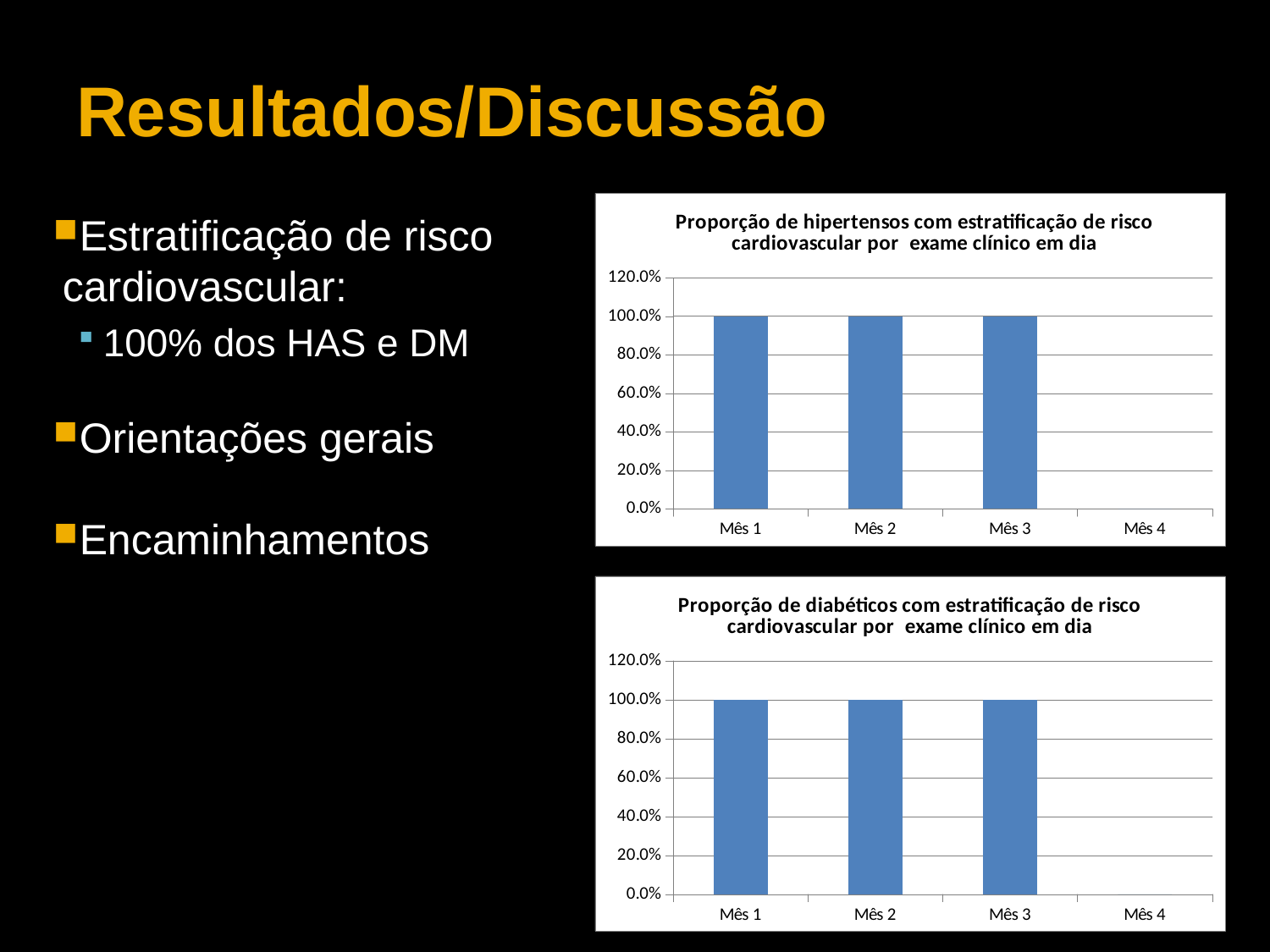
In the top chart (Proporção de hipertensos), what is the difference between the values for Mês 1 and Mês 2? 0.0% In the bottom chart (Proporção de diabéticos), is the value for Mês 1 greater or less than 80.0%? greater In the top chart (Proporção de hipertensos), do the values change from Mês 1 to Mês 3? No, they stay constant In the bottom chart (Proporção de diabéticos), which category has no bar plotted? Mês 4 In the top chart (Proporção de hipertensos), what is the value for Mês 3? 100.0% What is the title of the bottom chart? Proporção de diabéticos com estratificação de risco cardiovascular por exame clínico em dia In the bottom chart (Proporção de diabéticos), what is the value for Mês 3? 100.0% In the bottom chart (Proporção de diabéticos), how many categories are shown on the x axis? 4 What kind of chart is the top chart (Proporção de hipertensos)? Bar chart In the bottom chart (Proporção de diabéticos), what is the value for Mês 2? 100.0% In the top chart (Proporção de hipertensos), what is the value for Mês 1? 100.0% In the top chart (Proporção de hipertensos), how many categories are shown on the x axis? 4